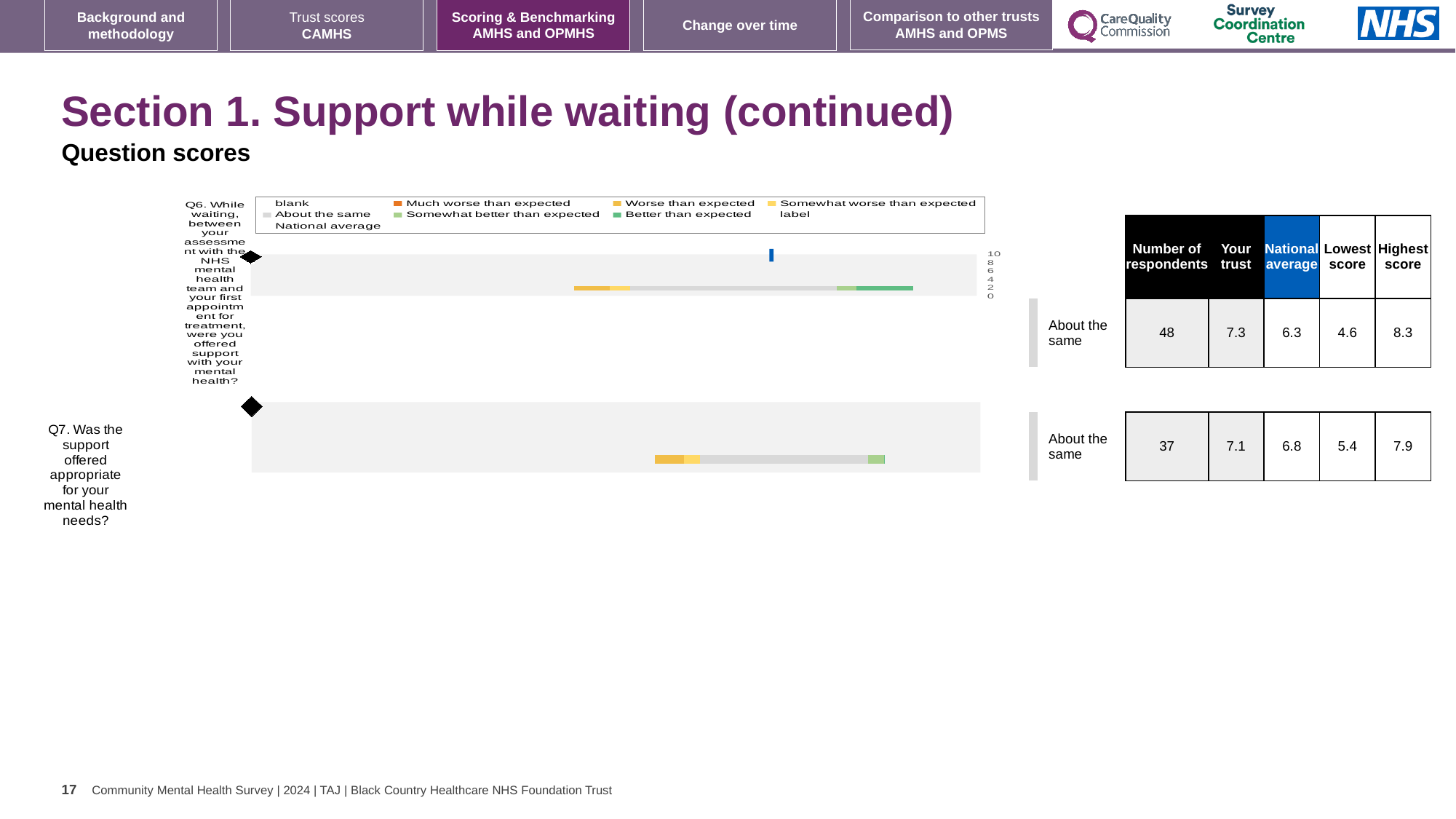
Which question has the higher 'Your trust' score, Q6 or Q7? Q6 What is the 'Your trust' score for Q7 in the table beside the chart? 7.1 How many question charts are shown on the slide? 2 For Q7, what is the difference between the highest score and the lowest score in the table? 2.5 Which legend entry is shown in orange? Much worse than expected Which category is the trust's Q6 result placed in? About the same What kind of chart is used to show the Q6 score? bar chart What is the national average score for Q7? 6.8 How many respondents are shown for Q6 in the table beside the chart? 48 Which category is the trust's Q7 result placed in? About the same For Q6, which is larger: the 'Your trust' score or the 'National average'? Your trust